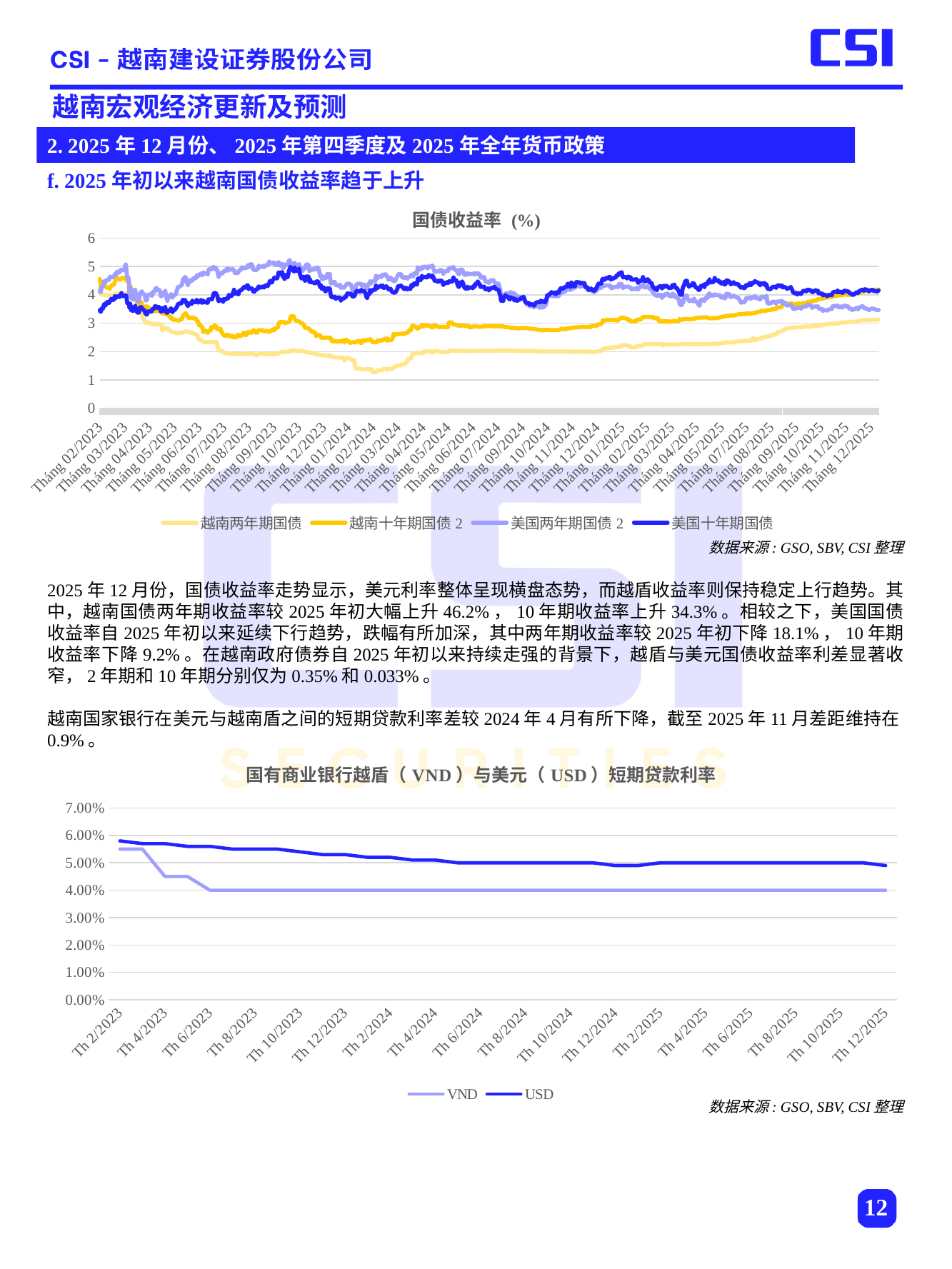
What kind of chart is the bottom chart (国有商业银行越盾（VND）与美元（USD）短期贷款利率)? line chart In the top chart (国债收益率), is the value for 越南两年期国债 at Tháng 03/2024 greater or less than 2? less How many series does the legend of the bottom chart (短期贷款利率) list? 2 How many series does the legend of the top chart (国债收益率) list? 4 In the top chart (国债收益率), which is higher at Tháng 03/2024: 美国十年期国债 or 越南两年期国债? 美国十年期国债 What kind of chart is the top chart titled 国债收益率 (%)? line chart In the bottom chart (短期贷款利率), which is higher at Th 12/2025: VND or USD? USD In the bottom chart (短期贷款利率), does the USD line rise or fall from Th 2/2023 to Th 12/2025? fall In the top chart (国债收益率), does the 越南两年期国债 line rise or fall from Tháng 01/2025 to Tháng 12/2025? rise What is the title of the top chart on the slide? 国债收益率 (%) In the bottom chart (短期贷款利率), is the value for USD at Th 2/2023 greater or less than 5.00%? greater In the top chart (国债收益率), is the value for 美国两年期国债 2 at Tháng 09/2023 greater or less than 4? greater